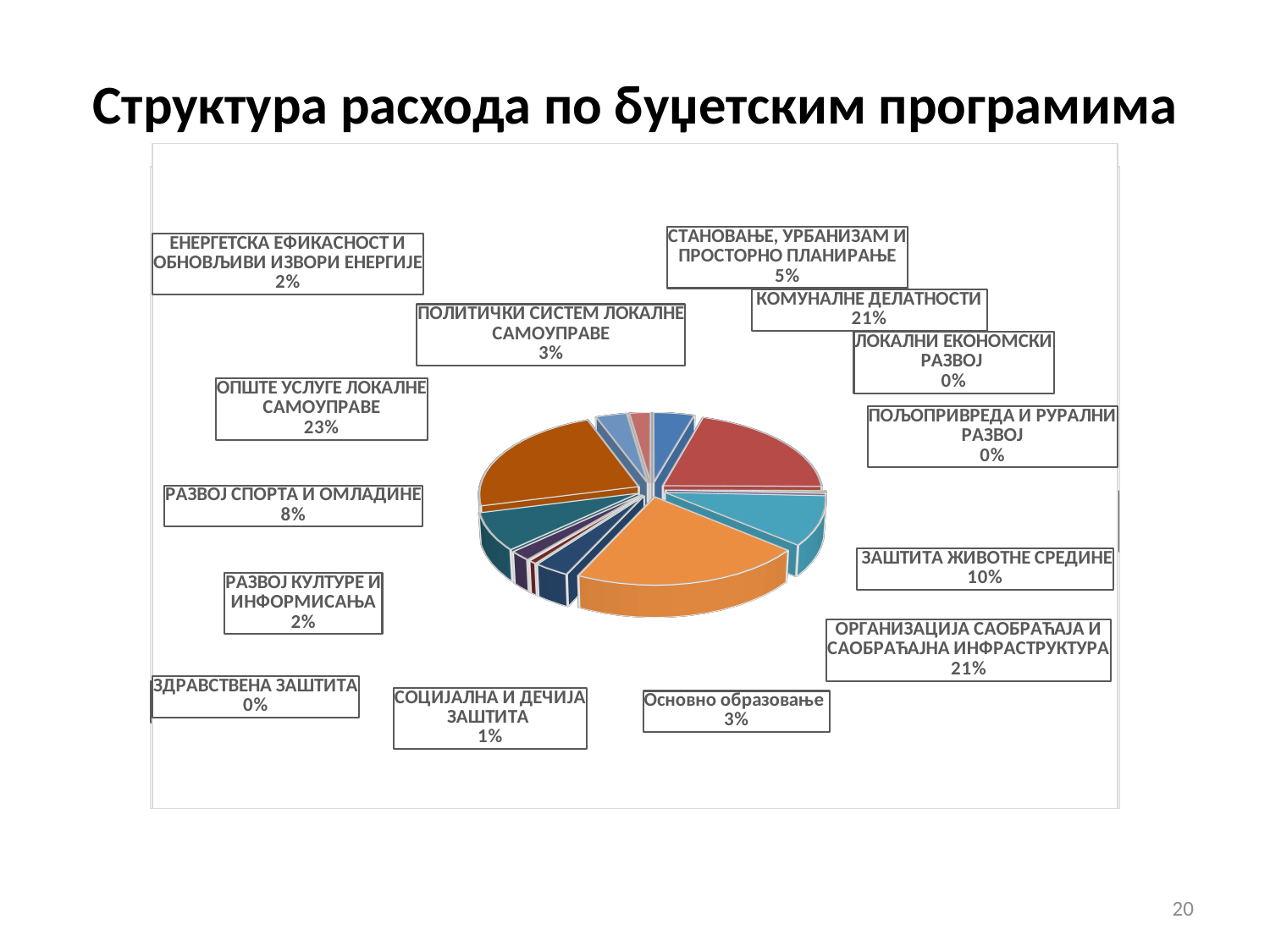
How many program categories are labelled on the pie chart? 14 What percentage is shown for Основно образовање? 3% What is the difference in percentage points between ОПШТЕ УСЛУГЕ ЛОКАЛНЕ САМОУПРАВЕ and ЗАШТИТА ЖИВОТНЕ СРЕДИНЕ? 13 What kind of chart is shown on the slide? pie chart What is the title of the slide? Структура расхода по буџетским програмима What percentage is shown for РАЗВОЈ СПОРТА И ОМЛАДИНЕ? 8% What percentage is shown for КОМУНАЛНЕ ДЕЛАТНОСТИ? 21% What percentage is shown for ЗАШТИТА ЖИВОТНЕ СРЕДИНЕ? 10% Which has a larger share: СТАНОВАЊЕ, УРБАНИЗАМ И ПРОСТОРНО ПЛАНИРАЊЕ or РАЗВОЈ СПОРТА И ОМЛАДИНЕ? РАЗВОЈ СПОРТА И ОМЛАДИНЕ What percentage is shown for СОЦИЈАЛНА И ДЕЧИЈА ЗАШТИТА? 1% Which program has the largest share of expenditure? ОПШТЕ УСЛУГЕ ЛОКАЛНЕ САМОУПРАВЕ What share of expenditure goes to ОПШТЕ УСЛУГЕ ЛОКАЛНЕ САМОУПРАВЕ? 23%